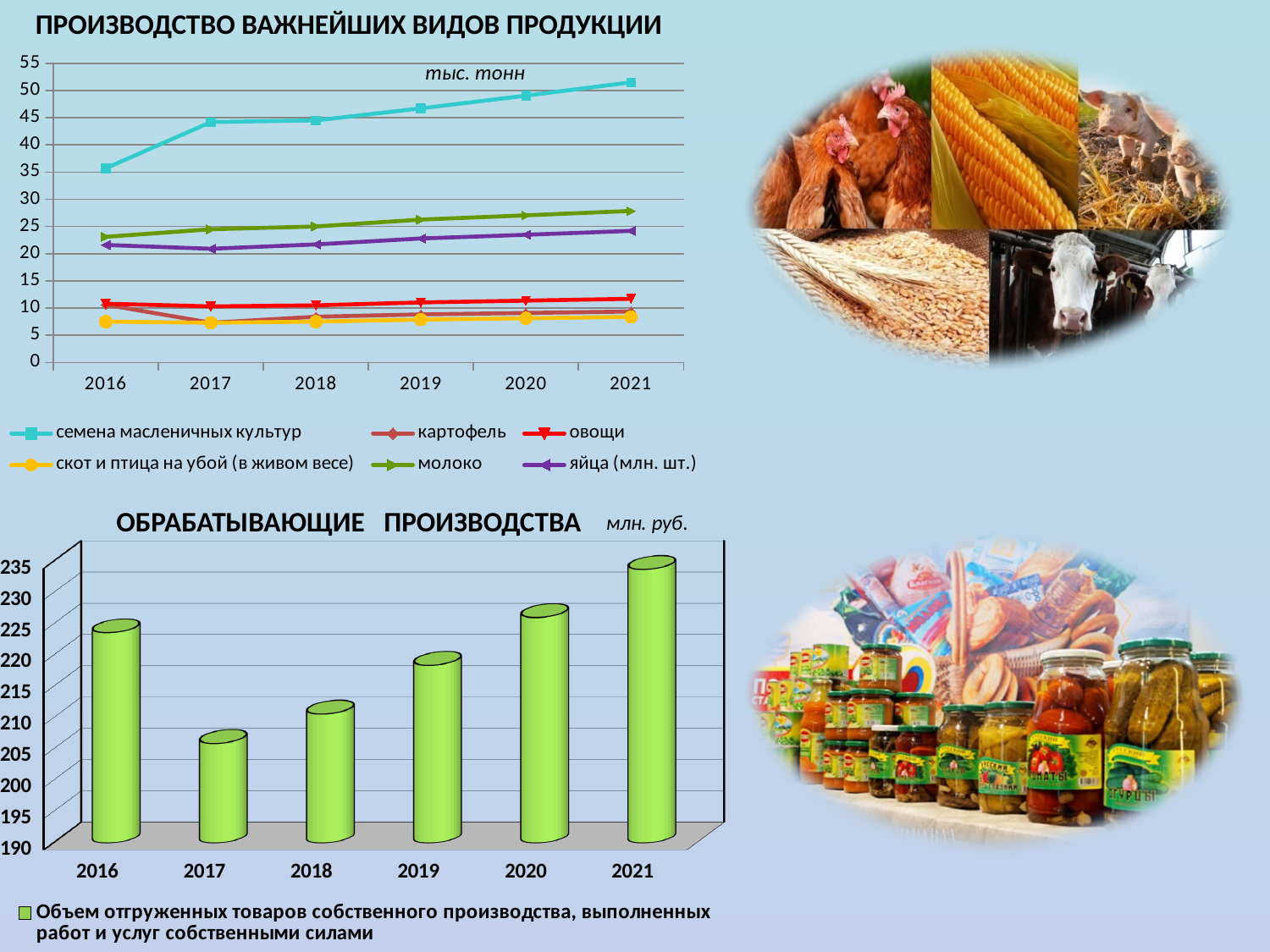
In the bottom chart «ОБРАБАТЫВАЮЩИЕ ПРОИЗВОДСТВА», which year has the lowest value? 2017 In the top chart «ПРОИЗВОДСТВО ВАЖНЕЙШИХ ВИДОВ ПРОДУКЦИИ», is the value for «семена масленичных культур» in 2016 greater or less than 40? less In the bottom chart «ОБРАБАТЫВАЮЩИЕ ПРОИЗВОДСТВА», which year has the highest value? 2021 In the top chart «ПРОИЗВОДСТВО ВАЖНЕЙШИХ ВИДОВ ПРОДУКЦИИ», which is larger in 2021: «молоко» or «яйца (млн. шт.)»? молоко What kind of chart is the bottom chart titled «ОБРАБАТЫВАЮЩИЕ ПРОИЗВОДСТВА»? bar chart In the top chart «ПРОИЗВОДСТВО ВАЖНЕЙШИХ ВИДОВ ПРОДУКЦИИ», which series has the highest values across all years? семена масленичных культур In the top chart «ПРОИЗВОДСТВО ВАЖНЕЙШИХ ВИДОВ ПРОДУКЦИИ», is the value for «молоко» in 2021 greater or less than 25? greater What unit is shown on the top chart «ПРОИЗВОДСТВО ВАЖНЕЙШИХ ВИДОВ ПРОДУКЦИИ»? тыс. тонн What kind of chart is the top chart titled «ПРОИЗВОДСТВО ВАЖНЕЙШИХ ВИДОВ ПРОДУКЦИИ»? line chart In the bottom chart «ОБРАБАТЫВАЮЩИЕ ПРОИЗВОДСТВА», is the value for 2021 greater or less than 230? greater How many series does the legend of the top chart «ПРОИЗВОДСТВО ВАЖНЕЙШИХ ВИДОВ ПРОДУКЦИИ» list? 6 In the top chart «ПРОИЗВОДСТВО ВАЖНЕЙШИХ ВИДОВ ПРОДУКЦИИ», does the series «семена масленичных культур» rise or fall from 2016 to 2021? rise